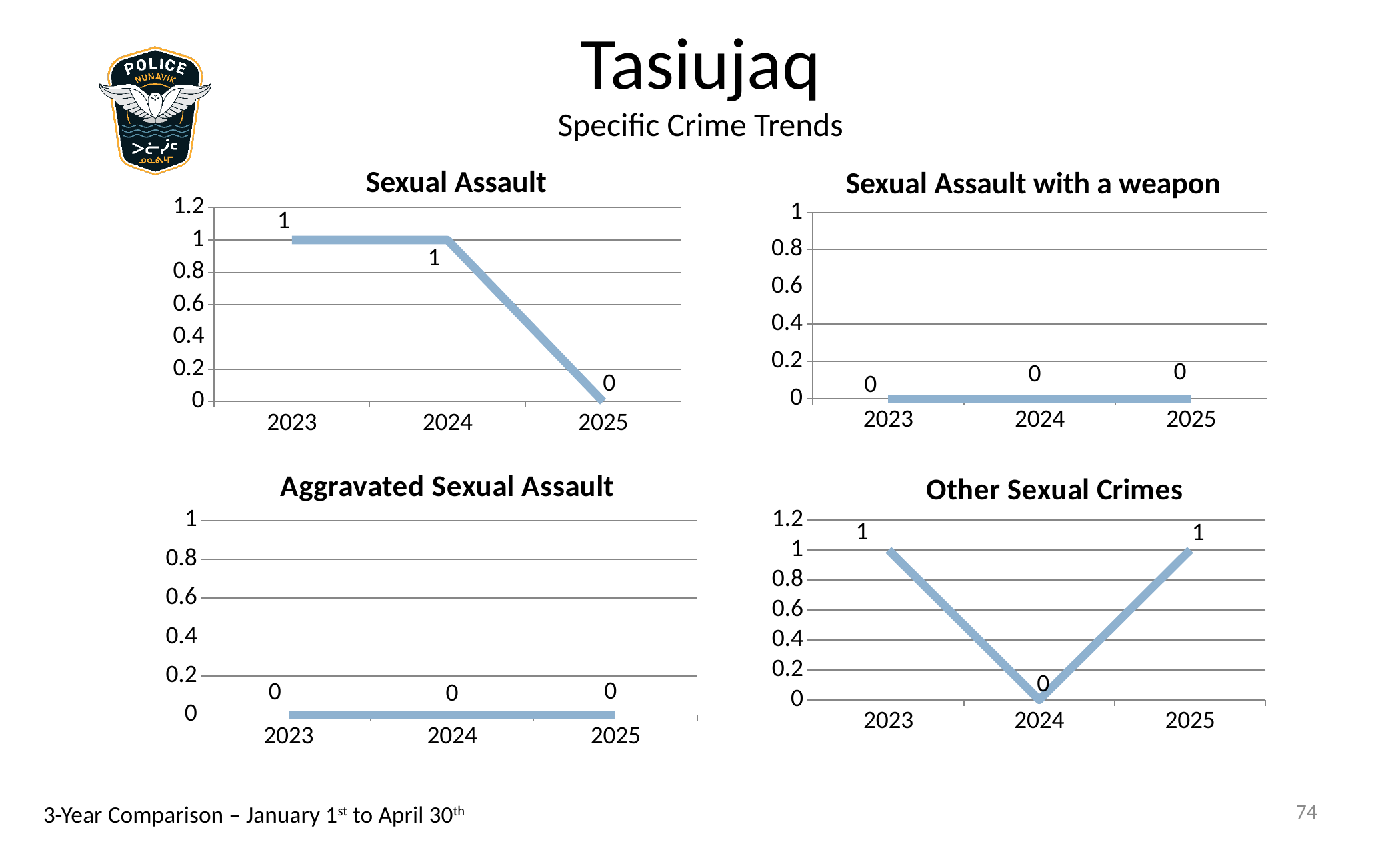
In the Sexual Assault chart, what is the value for 2025? 0 In the Other Sexual Crimes chart, which is larger, the value for 2023 or the value for 2024? 2023 What kind of chart is the Sexual Assault chart? Line chart In the Sexual Assault with a weapon chart, what is the value for 2024? 0 In the Sexual Assault chart, do the values rise or fall from 2024 to 2025? Fall In the Sexual Assault chart, what is the value for 2023? 1 In the Other Sexual Crimes chart, what is the value for 2024? 0 In the Other Sexual Crimes chart, which year has the lowest value? 2024 In the Sexual Assault chart, which year has the lowest value? 2025 How many years are plotted in the Aggravated Sexual Assault chart? 3 In the Sexual Assault chart, what is the difference between the 2024 and 2025 values? 1 In the Other Sexual Crimes chart, what is the value for 2025? 1